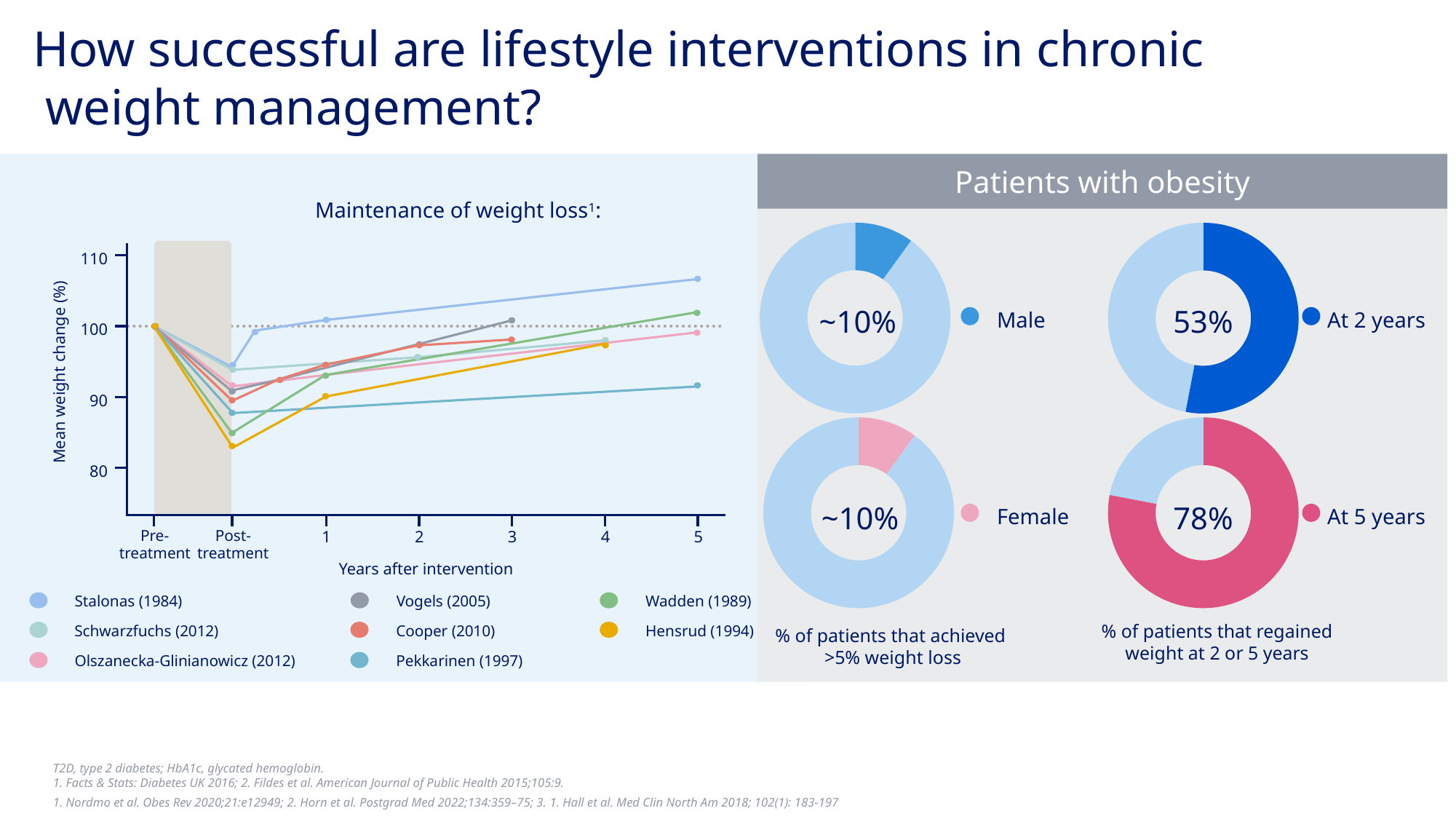
In the 'Maintenance of weight loss' chart, which study has the highest mean weight change at 5 years after intervention? Stalonas (1984) In the 'Maintenance of weight loss' chart, what is the mean weight change (%) for all studies at pre-treatment? 100 In the 'Maintenance of weight loss' chart, is the post-treatment value for Hensrud (1994) greater or less than 90? less In the 'Maintenance of weight loss' chart, is the value for Stalonas (1984) at 5 years greater or less than 100? greater In the 'Patients with obesity' panel, what percentage of patients regained weight at 2 years? 53% How many studies (series) does the legend of the 'Maintenance of weight loss' chart list? 8 In the 'Maintenance of weight loss' chart, is the value for Pekkarinen (1997) at 5 years greater or less than 100? less In the 'Maintenance of weight loss' chart, what is the label of the x axis? Years after intervention What type of chart is the 'Maintenance of weight loss' chart on the left? Line chart In the 'Patients with obesity' panel, what is the difference in percentage points between patients who regained weight at 5 years and at 2 years? 25 In the 'Patients with obesity' panel, what percentage of male patients achieved >5% weight loss? ~10% In the 'Patients with obesity' panel, what percentage of patients regained weight at 5 years? 78%